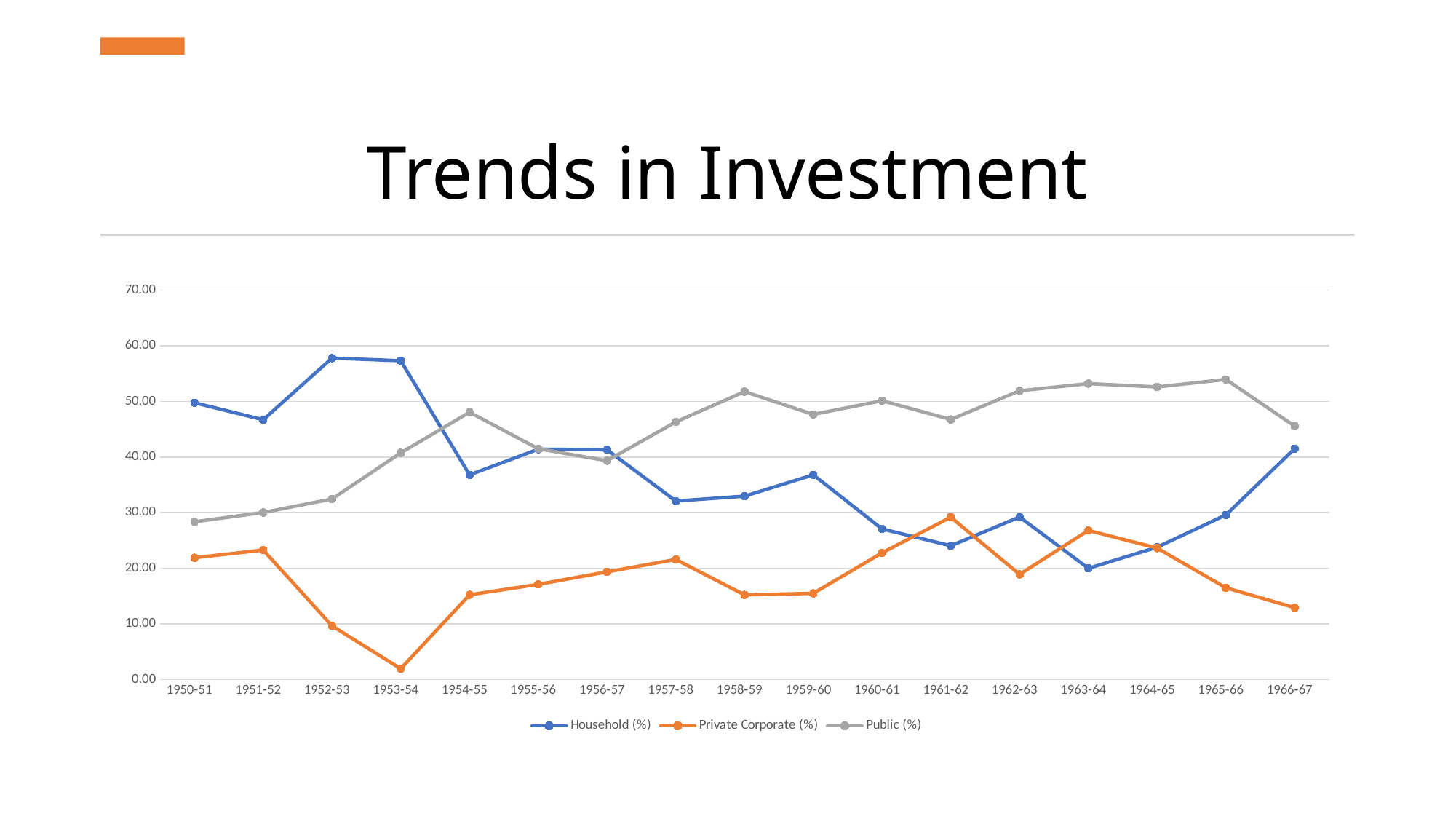
In 1961-62, which is larger: Household (%) or Private Corporate (%)? Private Corporate (%) In which year is the Private Corporate (%) value lowest? 1953-54 How many years are plotted along the x axis? 17 In which year is the Private Corporate (%) value highest? 1961-62 In 1966-67, which is larger: Household (%) or Private Corporate (%)? Household (%) How many series does the legend list? 3 Is the Public (%) value for 1966-67 greater or less than 40.00? greater Is the Household (%) value for 1952-53 greater or less than 50.00? greater Is the Private Corporate (%) value for 1953-54 greater or less than 10.00? less Does the Private Corporate (%) line rise or fall from 1961-62 to 1966-67? fall In which year is the Household (%) value lowest? 1963-64 What kind of chart is shown on the slide? line chart